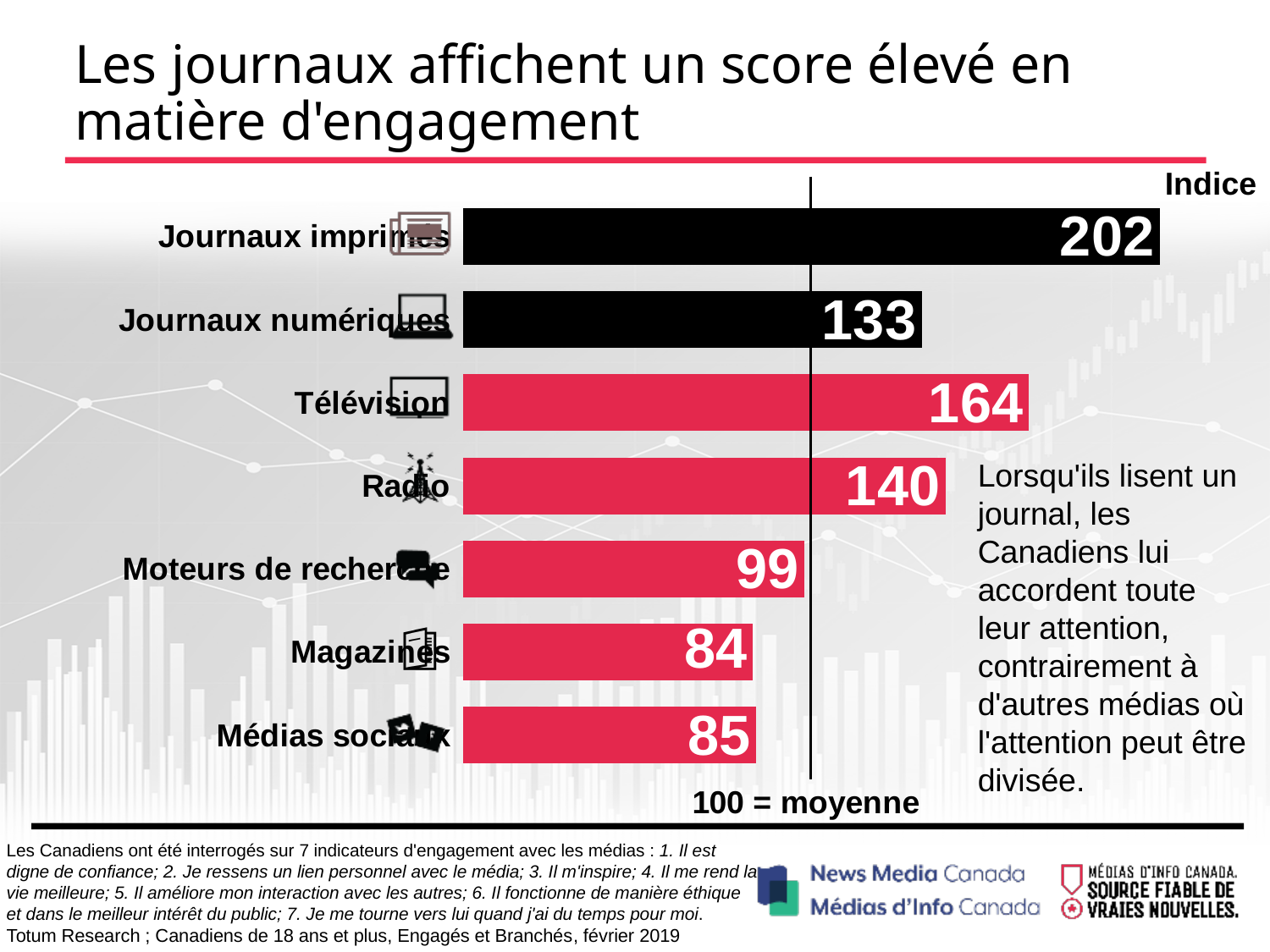
Which has a higher index value, Médias sociaux or Magazines? Médias sociaux How many categories are shown in the chart? 7 What is the difference between the index values for Télévision and Radio? 24 What is the index value for Journaux imprimés? 202 What value does the vertical reference line in the chart represent? 100 = moyenne Which category has the lowest index value? Magazines What kind of chart is shown on the slide? Bar chart What is the index value for Télévision? 164 Which category has the highest index value? Journaux imprimés Which has a higher index value, Radio or Journaux numériques? Radio What is the index value for Moteurs de recherche? 99 What is the difference between the index values for Journaux imprimés and Journaux numériques? 69